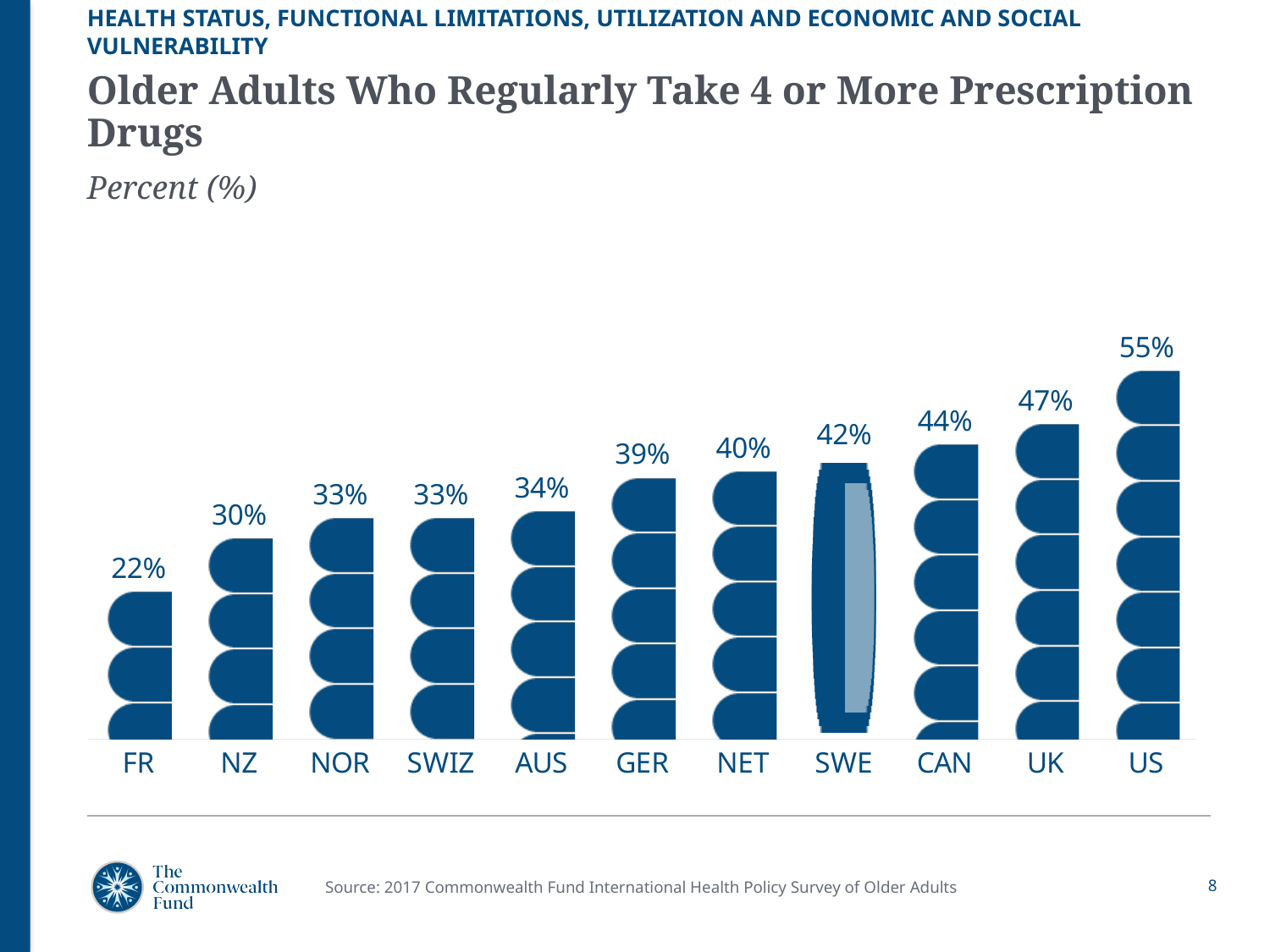
Which country's bar is highlighted in a lighter colour? SWE What is the difference between the values for the US and FR? 33 percentage points What is the value for SWE? 42% What is the difference between the values for CAN and GER? 5 percentage points What is the value for the US? 55% What is the value for FR? 22% How many countries are shown in the chart? 11 What kind of chart is shown on the slide? Bar chart Which country has the lowest value? FR Which country has the highest value? US Do the values rise or fall from left to right across the chart? Rise Which has a larger value, UK or NET? UK